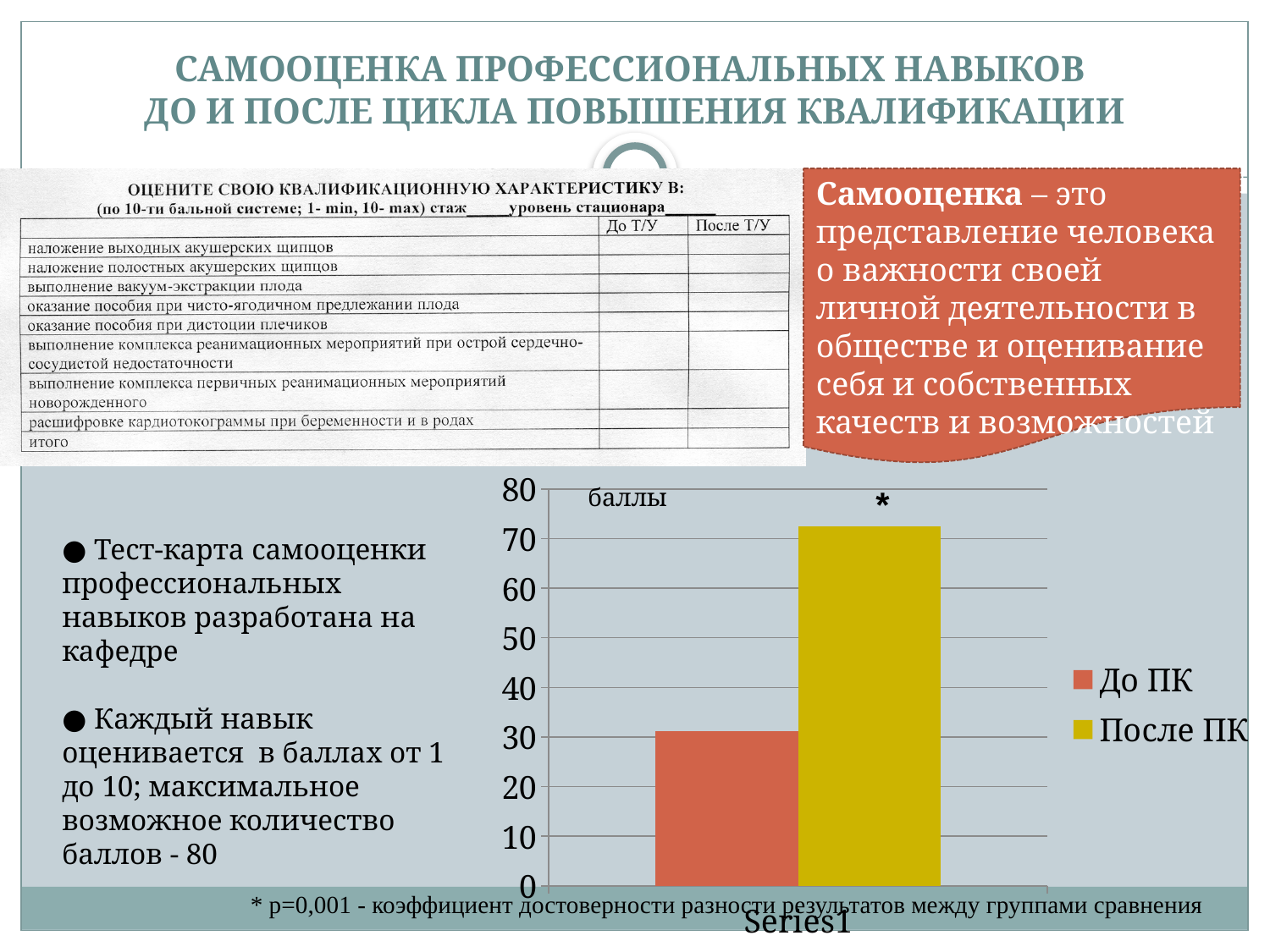
Is the value for До ПК greater or less than 40? less Which series has the taller bar, До ПК or После ПК? После ПК What label is shown at the top of the vertical axis of the chart? баллы Which series has the highest value in the chart? После ПК Which series has the lowest value in the chart? До ПК How many series does the chart legend list? 2 Is the value for После ПК greater or less than 80? less What kind of chart is shown on the slide? bar chart How many categories are shown on the x axis of the chart? 1 What colour is the bar for the series После ПК? yellow Is the value for До ПК greater or less than 20? greater